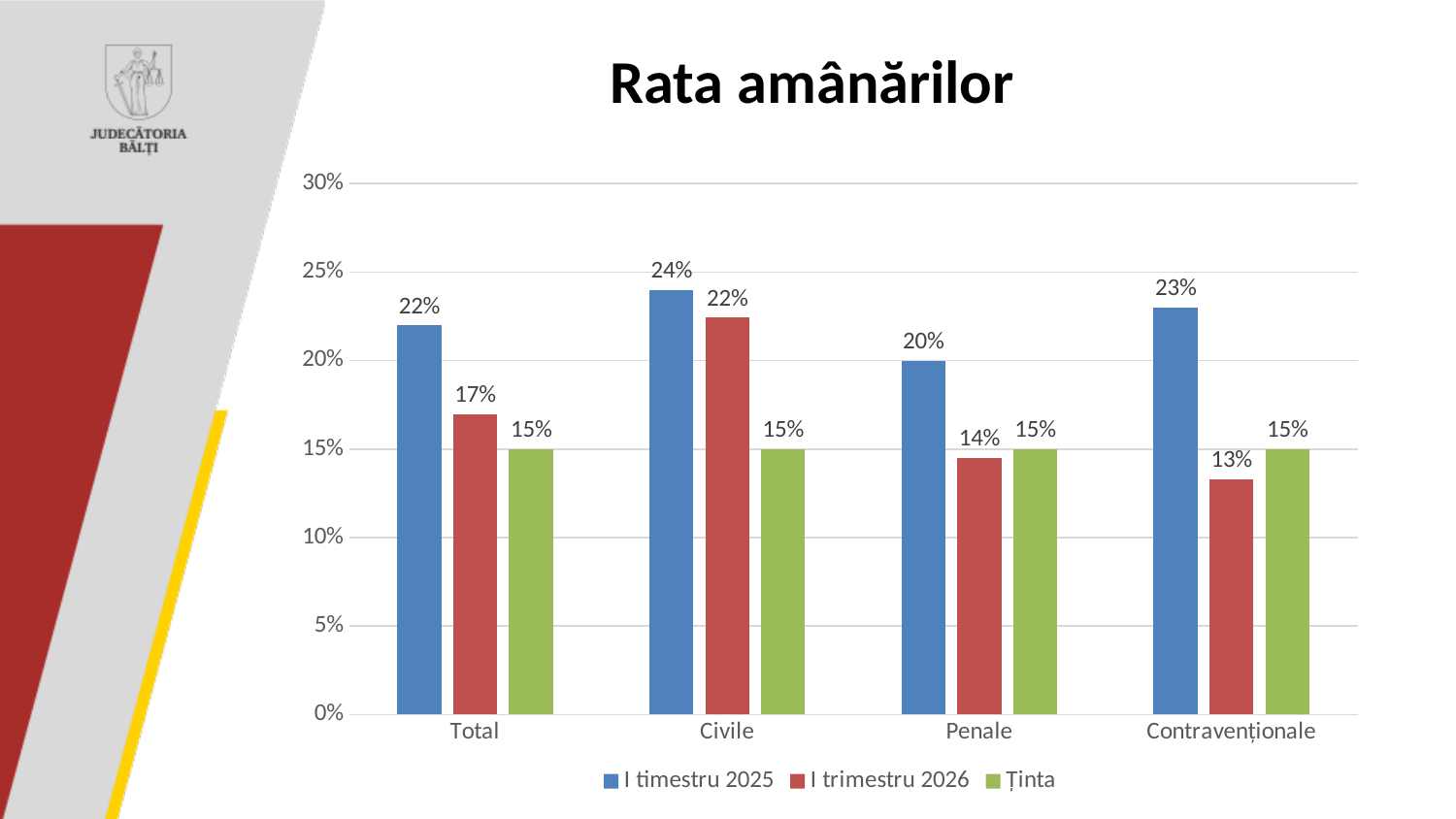
What kind of chart is shown on the slide? Bar chart How many categories are shown on the x axis? 4 What is the value for Contravenționale in the I trimestru 2026 series? 13% What is the title of the chart? Rata amânărilor What is the value for Civile in the I timestru 2025 series? 24% What colour are the Ținta bars? Green How many series does the legend list? 3 Which category has the highest value in the I timestru 2025 series? Civile Which is larger for Penale: the I timestru 2025 value or the Ținta value? I timestru 2025 Which category has the lowest value in the I trimestru 2026 series? Contravenționale What is the value for Penale in the I trimestru 2026 series? 14% What is the difference between the I timestru 2025 and I trimestru 2026 values for Total? 5%